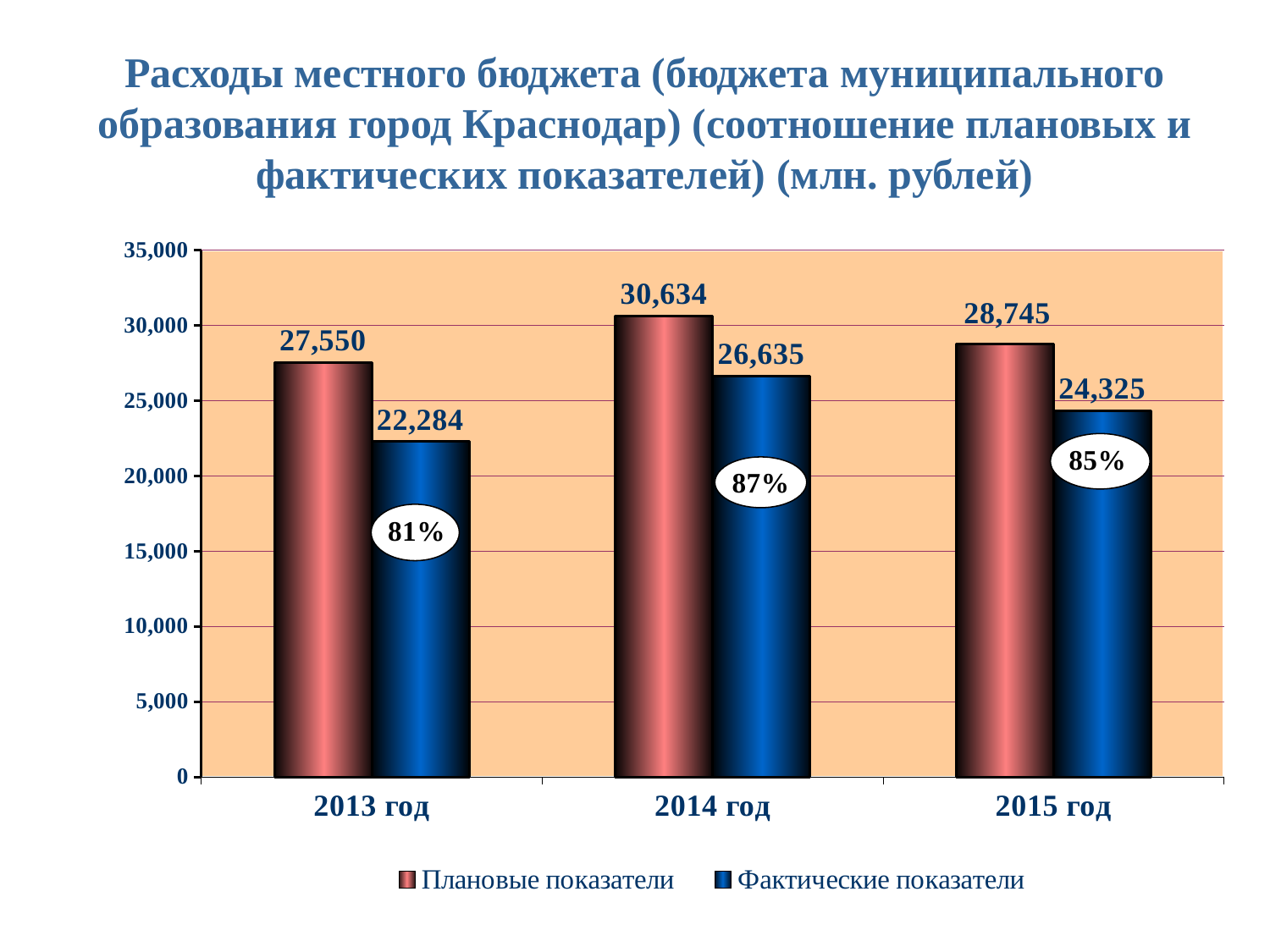
What is the difference between Плановые показатели and Фактические показатели in 2013 год? 5,266 Is the value of Фактические показатели for 2014 год greater or less than 25,000? greater What percentage is shown in the oval on the Фактические показатели bar for 2014 год? 87% What is the value of Фактические показатели for 2014 год? 26,635 Which is larger in 2015 год: Плановые показатели or Фактические показатели? Плановые показатели Which year has the lowest value for Фактические показатели? 2013 год How many series does the legend list? 2 What kind of chart is shown on the slide? bar chart Which year has the highest value for Плановые показатели? 2014 год What is the value of Фактические показатели for 2015 год? 24,325 How many years are shown on the x axis? 3 What is the value of Плановые показатели for 2013 год? 27,550